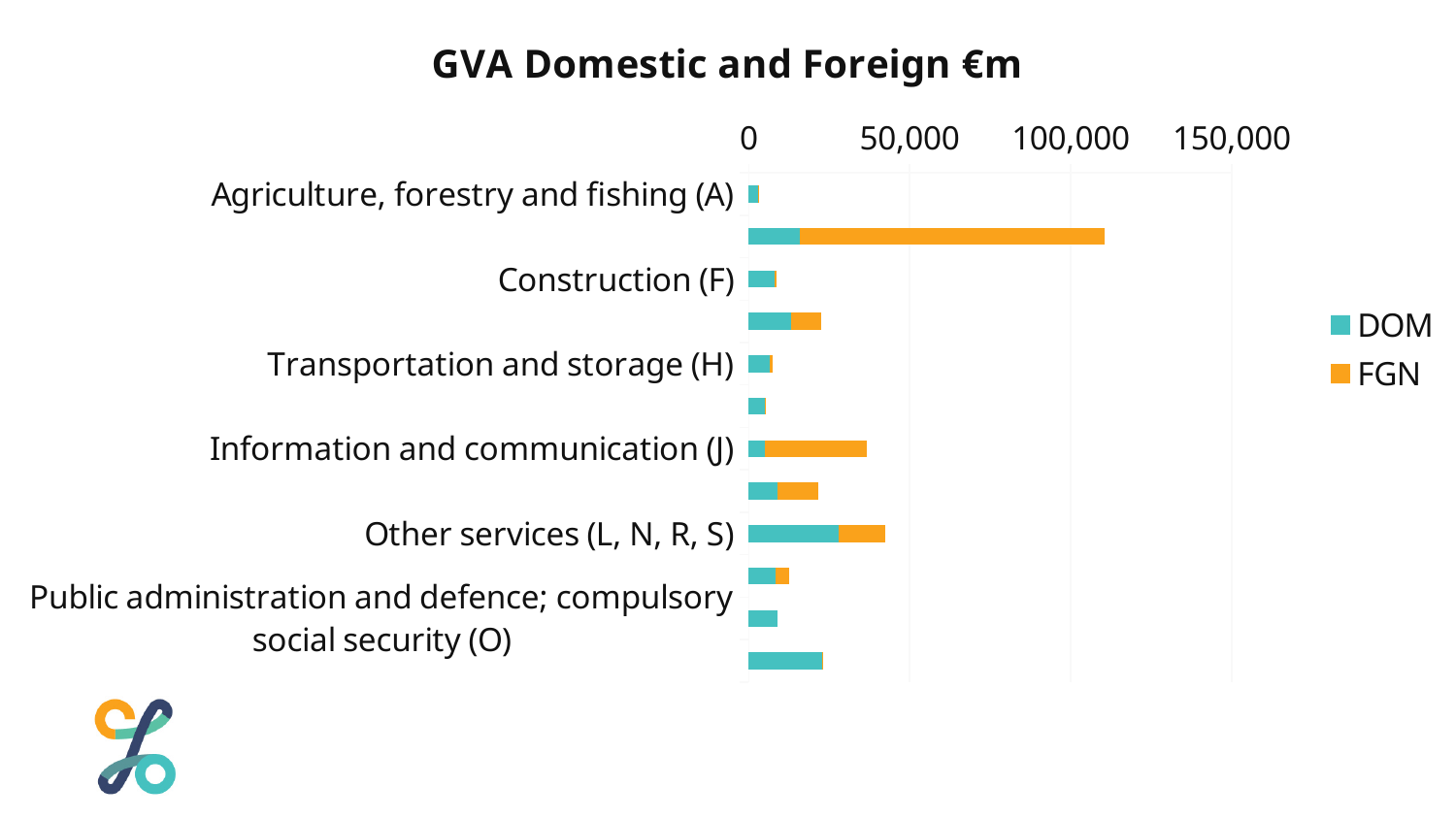
Is the total value for Other services (L, N, R, S) greater or less than 50,000? less How many bars are plotted in the chart? 12 Which has the larger total value, Information and communication (J) or Transportation and storage (H)? Information and communication (J) Is the value for Construction (F) greater or less than 50,000? less What is the title of the chart? GVA Domestic and Foreign €m What kind of chart is shown on the slide? Stacked bar chart For Information and communication (J), which series makes up the larger part of the bar, DOM or FGN? FGN How many series does the legend list? 2 What are the two series named in the legend? DOM and FGN Is the total value for Information and communication (J) greater or less than 50,000? less Which has the larger total value, Agriculture, forestry and fishing (A) or Other services (L, N, R, S)? Other services (L, N, R, S)